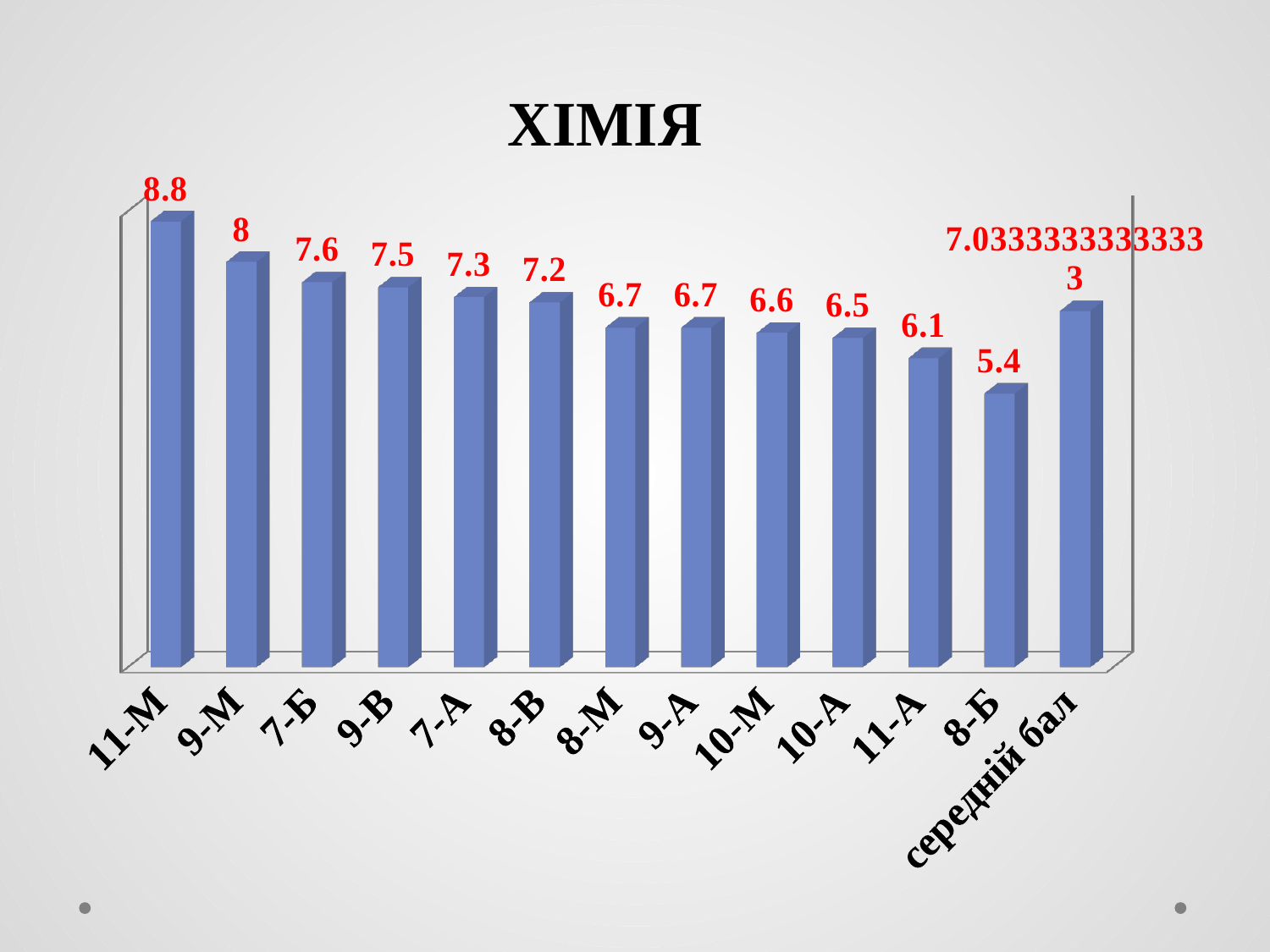
Which class has the highest value? 11-М Which category has the lowest value? 8-Б How many bars are shown in the chart? 13 What is the difference between the values for 11-М and 8-Б? 3.4 What is the value for 11-А? 6.1 What is the value for 8-Б? 5.4 What is the value for 9-В? 7.5 What is the value for 11-М? 8.8 What type of chart is shown on the slide? bar chart Do the values for the classes from 11-М to 8-Б rise or fall along the x axis? fall Which is larger, the value for 9-М or the value for 7-Б? 9-М What is the title of the chart? ХІМІЯ